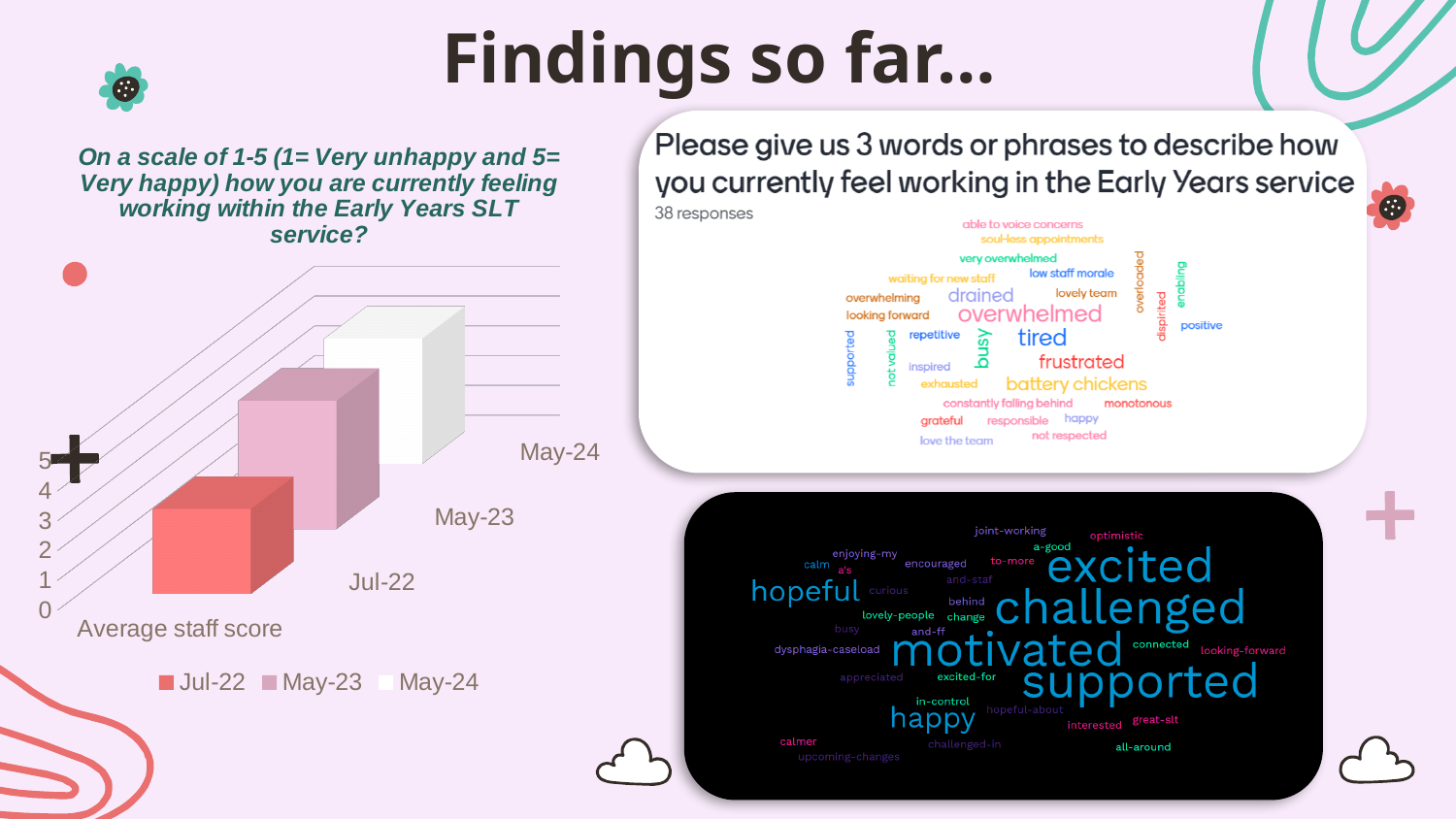
How many series does the legend of the bar chart list? 3 Is the value for Jul-22 in the bar chart greater or less than 4? less What is the category label shown on the x axis of the bar chart? Average staff score What kind of chart is shown on the left of the slide? bar chart Is the value for May-24 in the bar chart greater or less than 3? greater Do the average staff scores rise or fall from Jul-22 to May-24 in the bar chart? rise What is the highest value shown on the vertical axis of the bar chart? 5 In the bar chart, is the bar for May-23 taller or shorter than the bar for Jul-22? taller Which series has the lowest bar in the bar chart? Jul-22 What are the three series named in the bar chart's legend? Jul-22, May-23, May-24